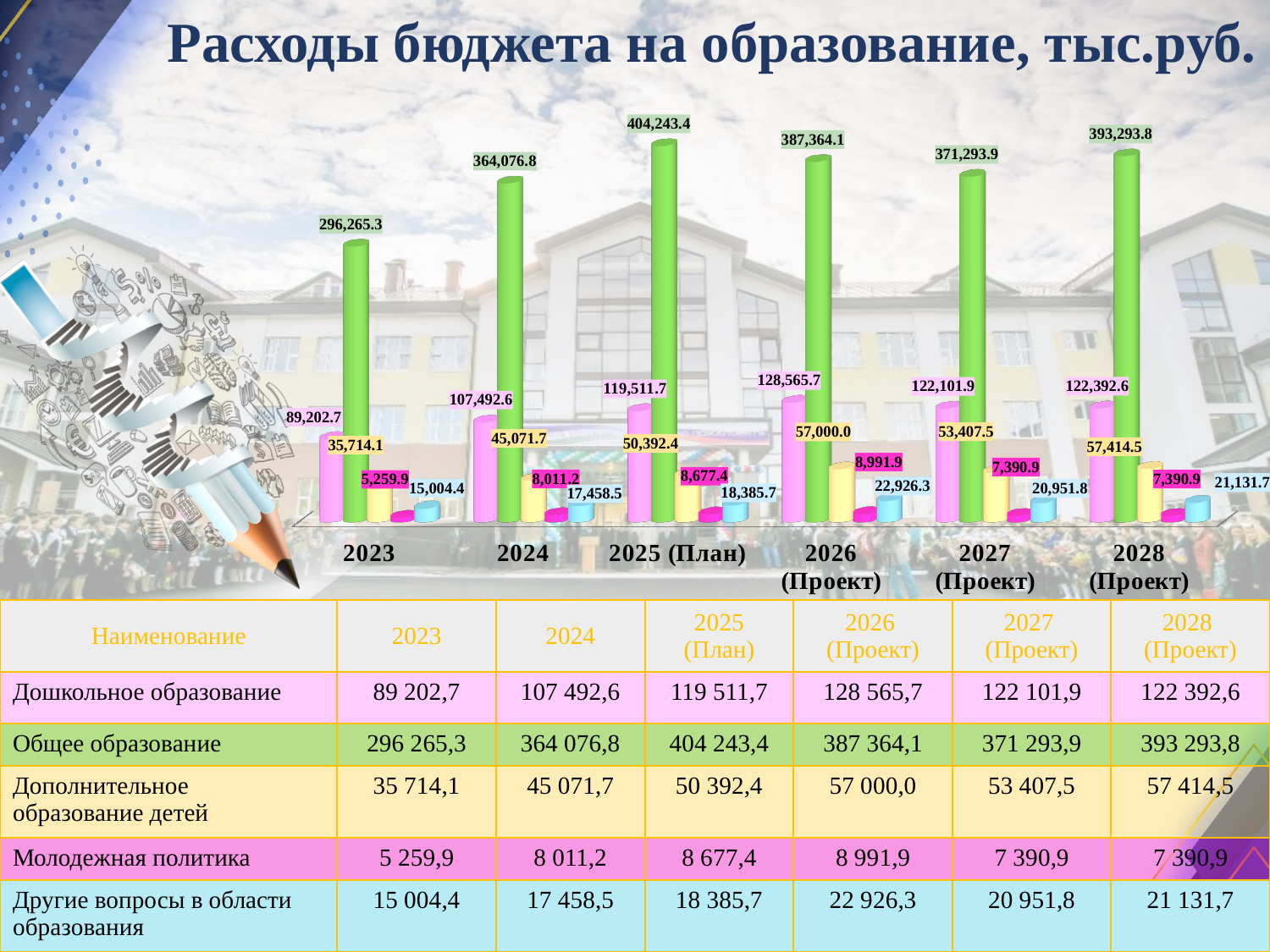
How many years (categories) are shown on the x axis of the chart? 6 In which year is the value for Дополнительное образование детей the highest? 2028 (Проект) Does the value for Общее образование rise or fall from 2023 to 2025 (План)? rise What is the difference between the Дошкольное образование values for 2024 and 2023? 18,289.9 In which year is the value for Общее образование the highest? 2025 (План) How many data series (bars per year) are plotted in the chart? 5 In which year is the value for Дошкольное образование the lowest? 2023 What is the difference between the Общее образование values for 2025 (План) and 2026 (Проект)? 16,879.3 What is the value for Общее образование in 2025 (План)? 404,243.4 What is the value for Другие вопросы в области образования in 2028 (Проект)? 21,131.7 Which is larger, the Молодежная политика value for 2026 (Проект) or for 2027 (Проект)? 2026 (Проект) What kind of chart is shown on the slide? bar chart